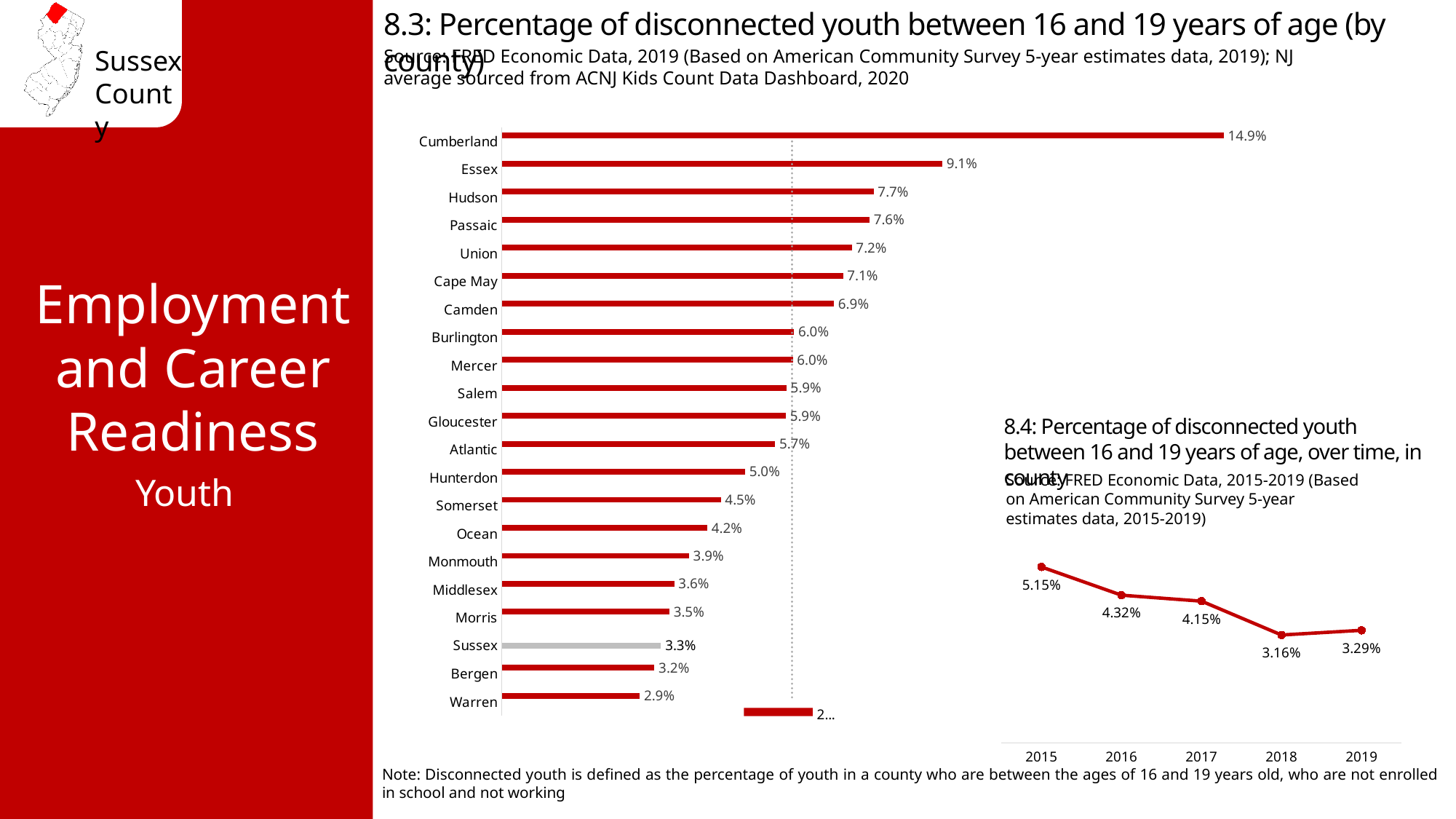
In chart 8.3 (by county), what is the difference between the values for Cumberland and Essex? 5.8% In chart 8.4 (disconnected youth over time), how many years are plotted? 5 In chart 8.3 (by county), what is the value for Hunterdon? 5.0% In chart 8.3 (by county), which has a higher value, Hudson or Camden? Hudson What kind of chart is chart 8.3 (percentage of disconnected youth by county)? Bar chart In chart 8.3 (by county), which bar is shown in grey instead of red? Sussex In chart 8.4 (disconnected youth over time), what is the value for 2015? 5.15% In chart 8.3 (percentage of disconnected youth by county), what is the value for Sussex? 3.3% In chart 8.3 (by county), which county has the highest percentage of disconnected youth? Cumberland In chart 8.4 (disconnected youth over time), which year has the lowest value? 2018 In chart 8.4 (disconnected youth over time), what is the difference between the 2015 and 2019 values? 1.86% In chart 8.3 (by county), which county has the lowest percentage of disconnected youth? Warren